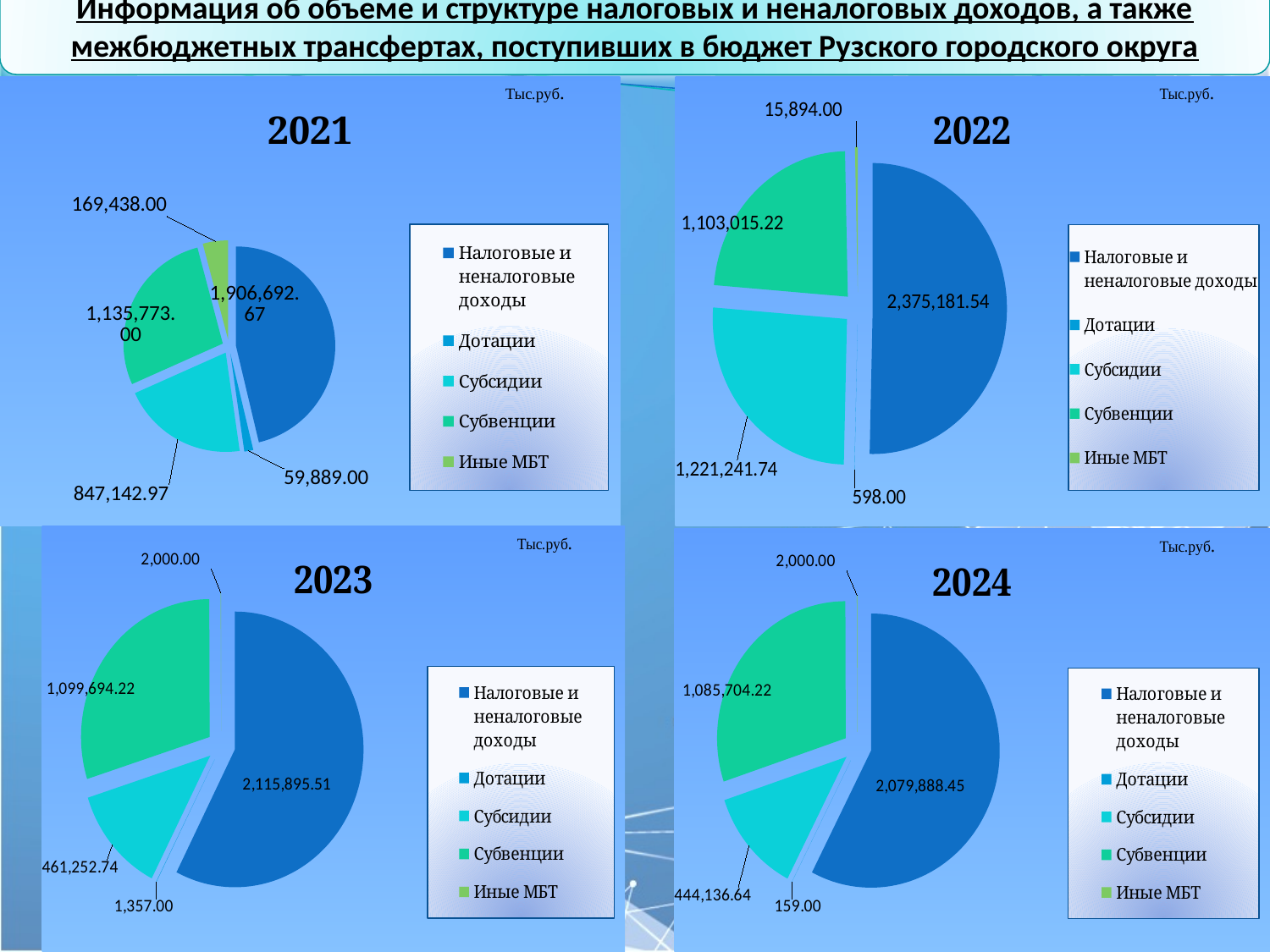
How many categories does the legend of the 2022 pie chart list? 5 In the 2024 pie chart, what is the difference between Субвенции and Субсидии? 641,567.58 In the 2024 pie chart, what is the value for Дотации? 159.00 In the 2023 pie chart, what is the value for Субвенции? 1,099,694.22 What type of chart is used for the 2023 data? Pie chart How many pie charts are shown on the slide? 4 In the 2021 pie chart, what is the value for Налоговые и неналоговые доходы? 1,906,692.67 In the 2023 pie chart, which is larger: Субсидии or Субвенции? Субвенции In the 2022 pie chart, which category has the smallest value? Дотации In the 2021 pie chart, which category has the largest value? Налоговые и неналоговые доходы In the 2021 pie chart, what is the value for Иные МБТ? 169,438.00 In the 2022 pie chart, what is the value for Субсидии? 1,221,241.74